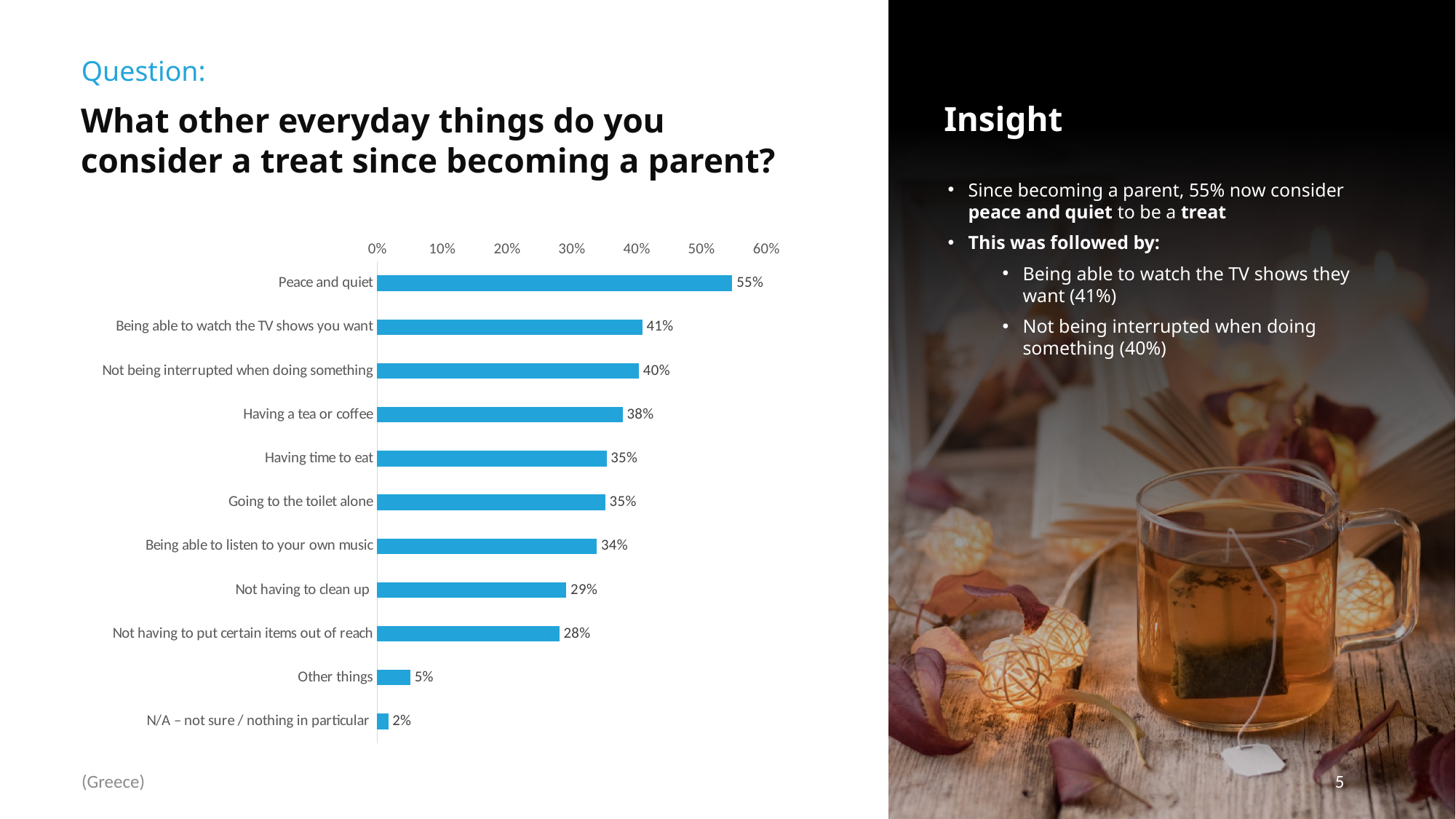
What is the value for 'Having a tea or coffee'? 38% Which category has the lowest value? N/A – not sure / nothing in particular Which is larger: 'Having time to eat' or 'Not having to clean up'? Having time to eat What is the difference between 'Peace and quiet' and 'Being able to watch the TV shows you want'? 14 percentage points What is the maximum value shown on the chart's percentage axis? 60% What percentage of respondents consider 'Peace and quiet' a treat? 55% Which category has the highest value? Peace and quiet How many categories are shown in the chart? 11 What kind of chart is shown on the slide? Bar chart What is the value for 'Not having to put certain items out of reach'? 28% Is the value for 'Being able to listen to your own music' greater or less than 30%? greater What is the difference between 'Not having to clean up' and 'Other things'? 24 percentage points